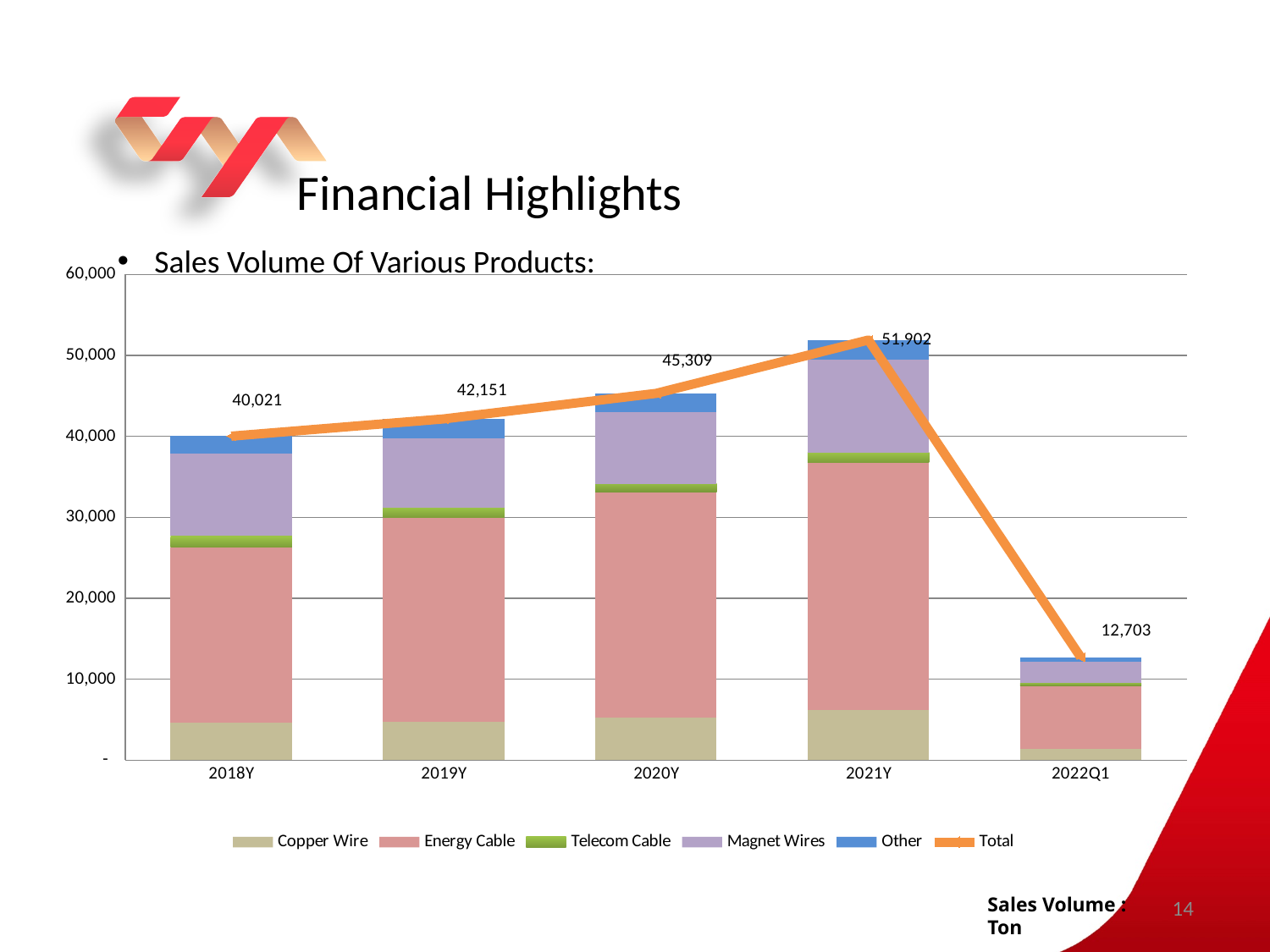
How many series does the legend list? 6 Which period has the highest Total sales volume? 2021Y Which period has the lowest Total sales volume? 2022Q1 How many periods are shown on the x axis? 5 What is the Total sales volume for 2021Y? 51,902 What is the difference between the Total sales volume in 2019Y and 2018Y? 2,130 Does the Total sales volume rise or fall from 2018Y to 2021Y? rise Is the Copper Wire value for 2021Y greater or less than 10,000? less What is the Total sales volume for 2018Y? 40,021 What is the difference between the Total sales volume in 2021Y and 2020Y? 6,593 What is the Total sales volume for 2022Q1? 12,703 Which is larger, the Total sales volume for 2020Y or for 2019Y? 2020Y